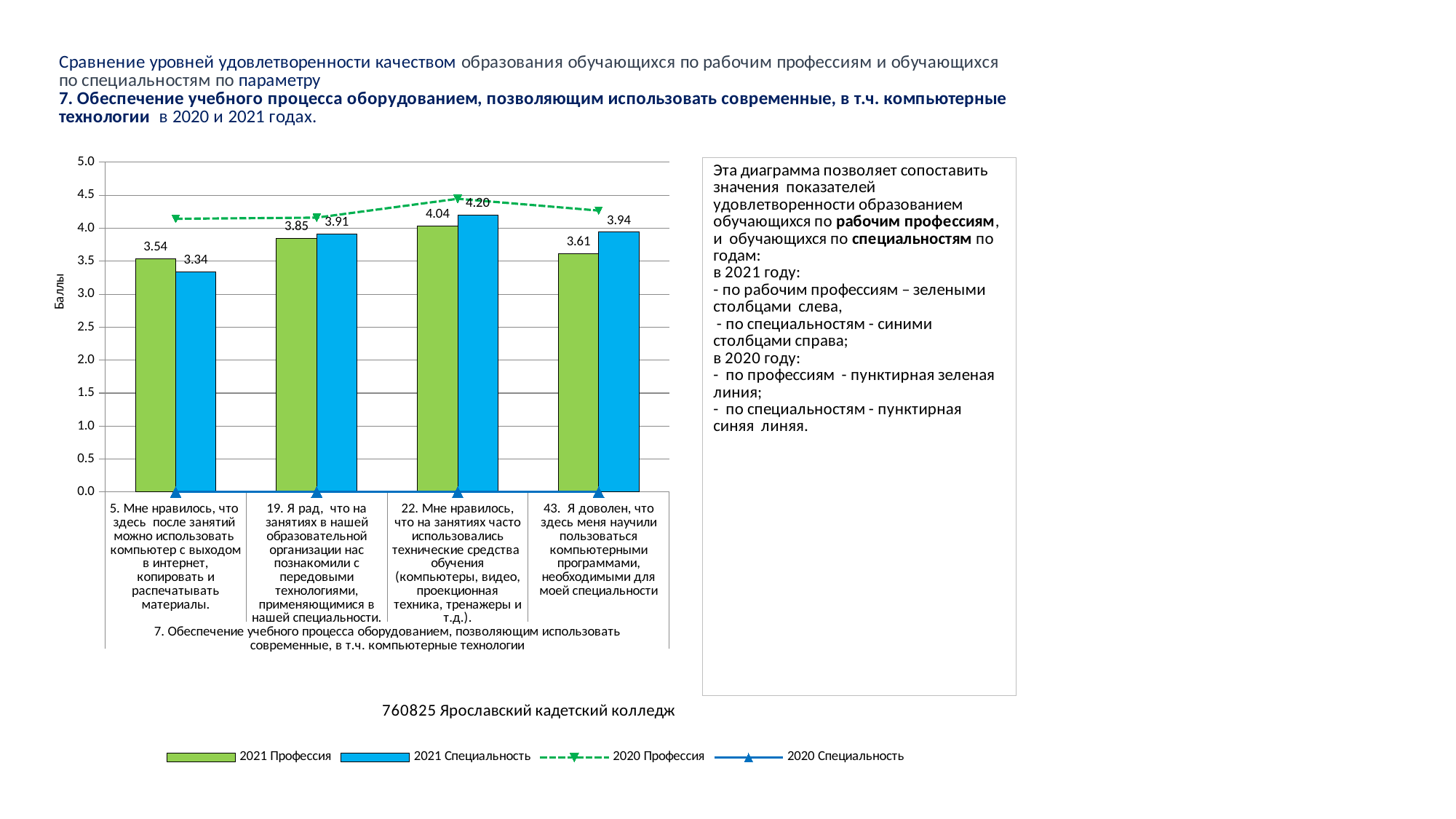
How many question categories are shown on the x axis? 4 Is the 2020 Профессия dashed line value for question 22 greater or less than 4.0? greater What is the label of the y axis? Баллы What is the difference between the 2021 Специальность and 2021 Профессия bars for question 43? 0.33 What is the value of the 2021 Специальность bar for question 22 ("Мне нравилось, что на занятиях часто использовались технические средства обучения...")? 4.20 For question 5, which is larger: the 2021 Профессия bar or the 2021 Специальность bar? 2021 Профессия Which question has the lowest 2021 Специальность bar? 5. Мне нравилось, что здесь после занятий можно использовать компьютер с выходом в интернет What is the value of the 2021 Специальность bar for question 43 ("Я доволен, что здесь меня научили пользоваться компьютерными программами...")? 3.94 What is the value of the 2021 Профессия bar for question 5 ("Мне нравилось, что здесь после занятий можно использовать компьютер...")? 3.54 What type of chart is used for the 2021 data? bar chart Which question has the highest 2021 Профессия bar? 22. Мне нравилось, что на занятиях часто использовались технические средства обучения How many series does the legend list? 4